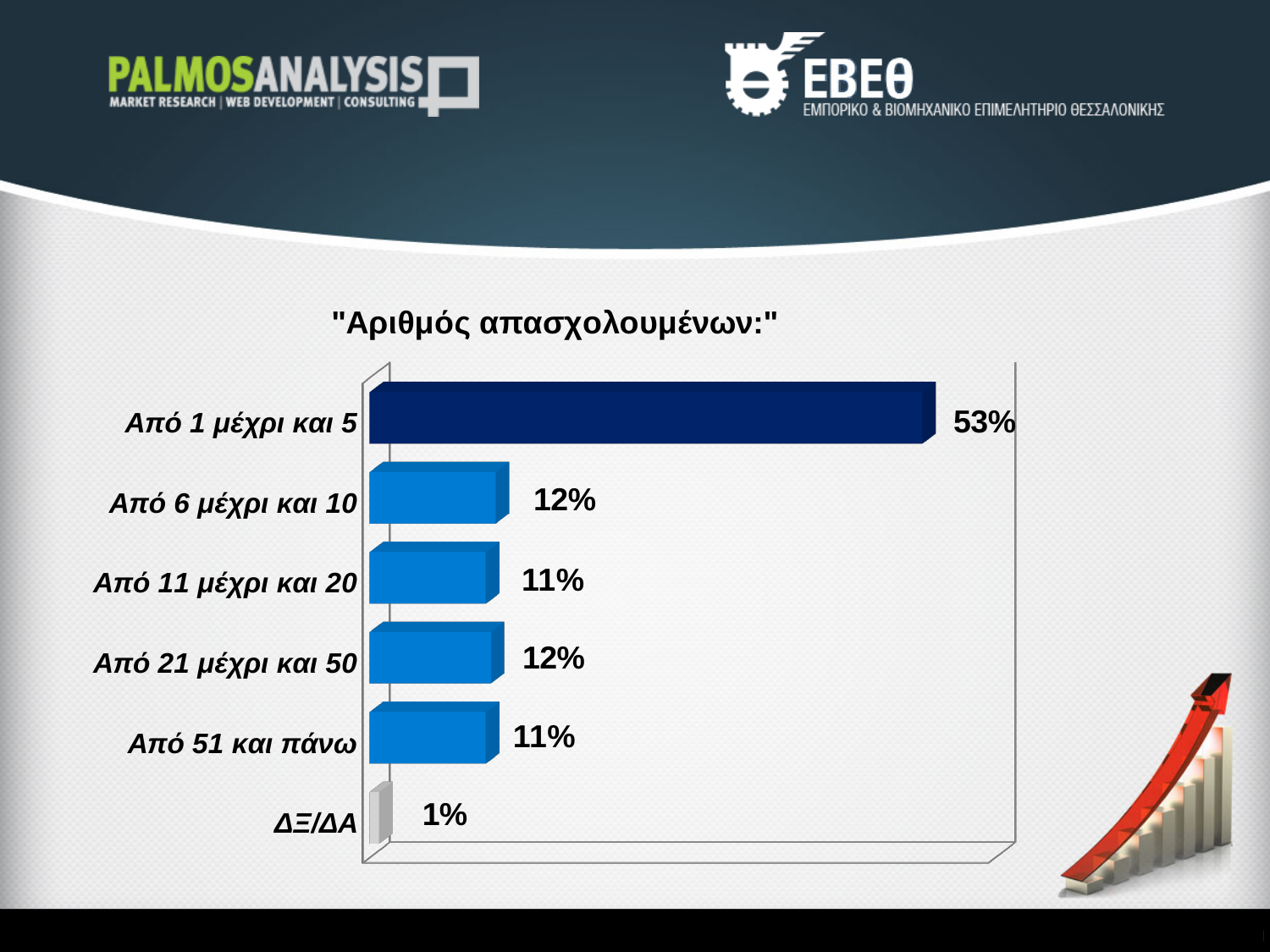
What is the value for "Από 11 μέχρι και 20"? 11% Which category has the highest value? Από 1 μέχρι και 5 What is the title of the chart? "Αριθμός απασχολουμένων:" What is the difference between the values for "Από 51 και πάνω" and "ΔΞ/ΔΑ"? 10% What is the difference between the values for "Από 1 μέχρι και 5" and "Από 6 μέχρι και 10"? 41% What is the value for "Από 1 μέχρι και 5"? 53% Which category has the lowest value? ΔΞ/ΔΑ Which is larger, the value for "Από 6 μέχρι και 10" or the value for "Από 51 και πάνω"? Από 6 μέχρι και 10 What is the value for "Από 21 μέχρι και 50"? 12% What is the value for "ΔΞ/ΔΑ"? 1% How many categories are shown in the chart? 6 What kind of chart is shown on the slide? Bar chart